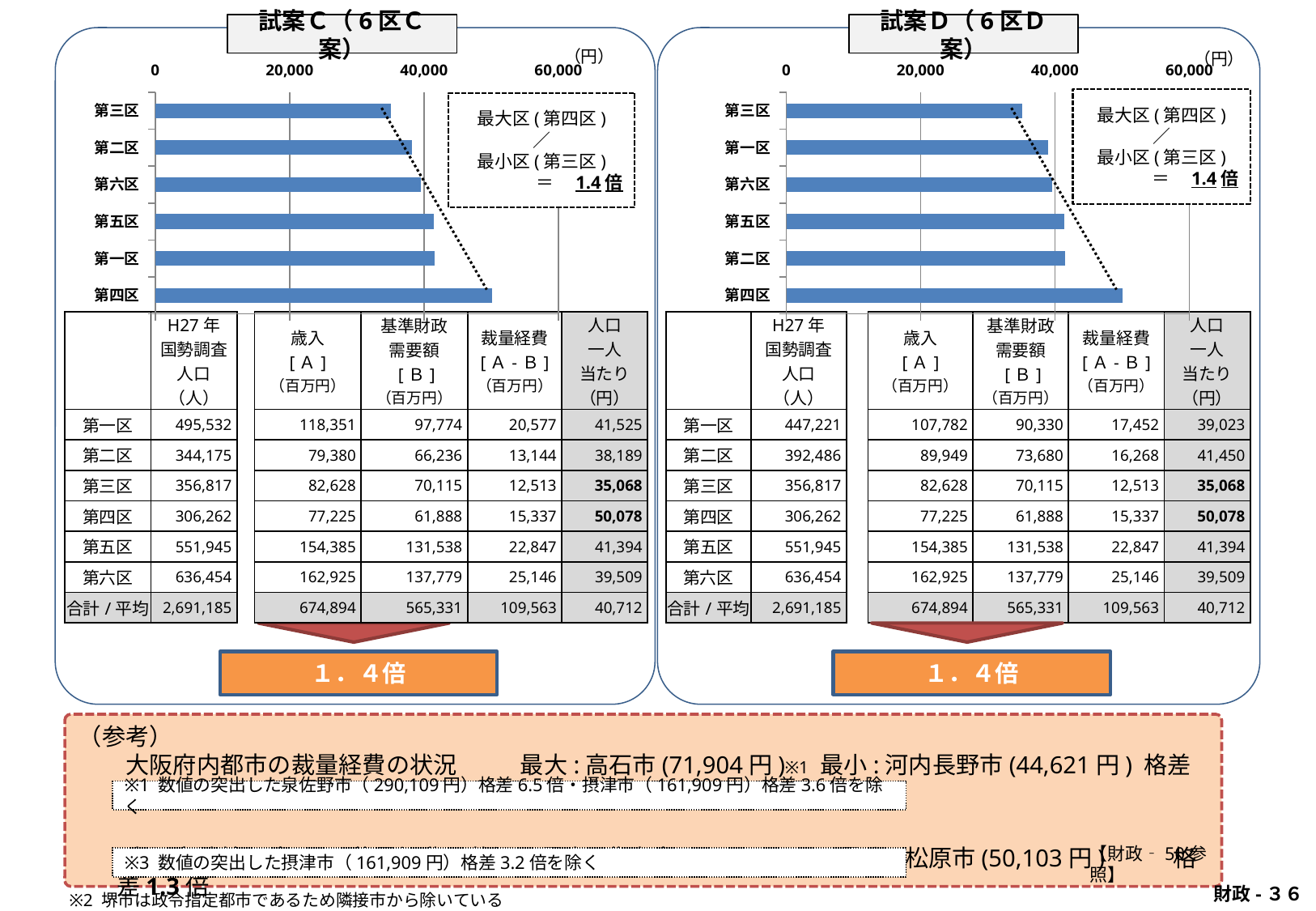
In the 試案C（6区C案） chart, is the value for 第三区 greater or less than 40,000? less In the 試案D（6区D案） chart, which 区 has the shortest bar? 第三区 In the 試案D（6区D案） chart, which 区 has the longest bar? 第四区 What kind of chart is the 試案C（6区C案） chart? bar chart How many 区 categories are plotted in the 試案C（6区C案） chart? 6 According to the 試案C（6区C案） table, what is the 人口一人当たり（円） value for 第四区? 50,078 In 試案C（6区C案）, what is the difference between the 人口一人当たり values of 第四区 (50,078) and 第三区 (35,068)? 15,010 In the 試案D（6区D案） chart, which has the larger value, 第四区 or 第六区? 第四区 In the 試案C（6区C案） chart, which 区 has the shortest bar? 第三区 In the 試案C（6区C案） chart, which 区 has the longest bar? 第四区 In the 試案C（6区C案） chart, is the value for 第四区 greater or less than 40,000? greater In the 試案D（6区D案） chart, what ratio of 最大区 to 最小区 is stated in the dashed box? 1.4倍